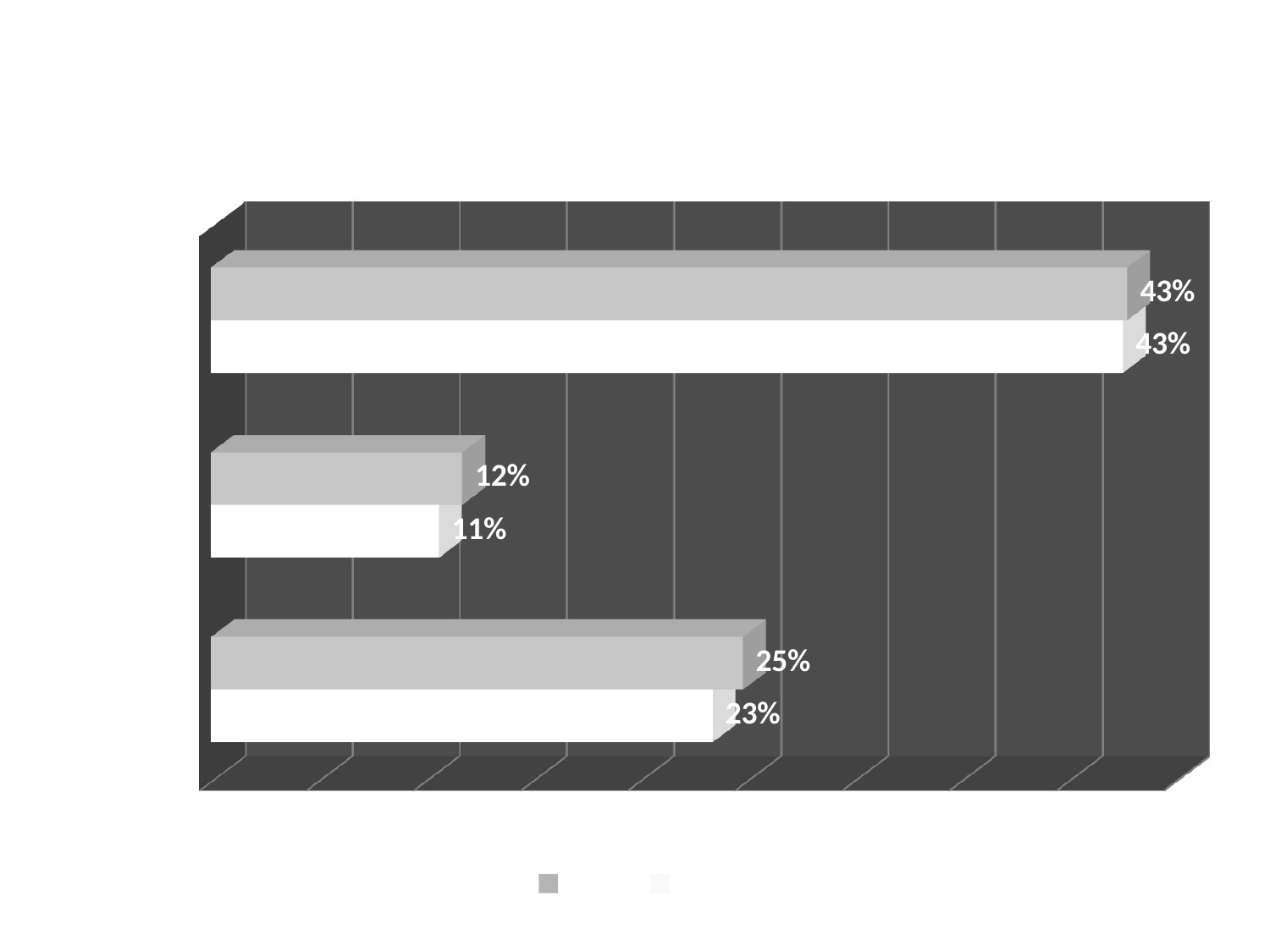
How many groups of bars (categories) does the chart show? 3 In the middle group, which bar is larger, the grey bar or the white bar? the grey bar What is the value of the white bar in the bottom group? 23% Which group of bars has the highest values? the top group What is the difference between the grey bar and the white bar in the bottom group? 2% Which group of bars has the lowest values? the middle group What kind of chart is shown on the slide? bar chart How many series does the legend show? 2 What is the value of the grey bar in the bottom group? 25% What is the difference between the grey bar in the top group and the grey bar in the middle group? 31% What is the value of the grey bar in the top group? 43% What is the value of the white bar in the middle group? 11%